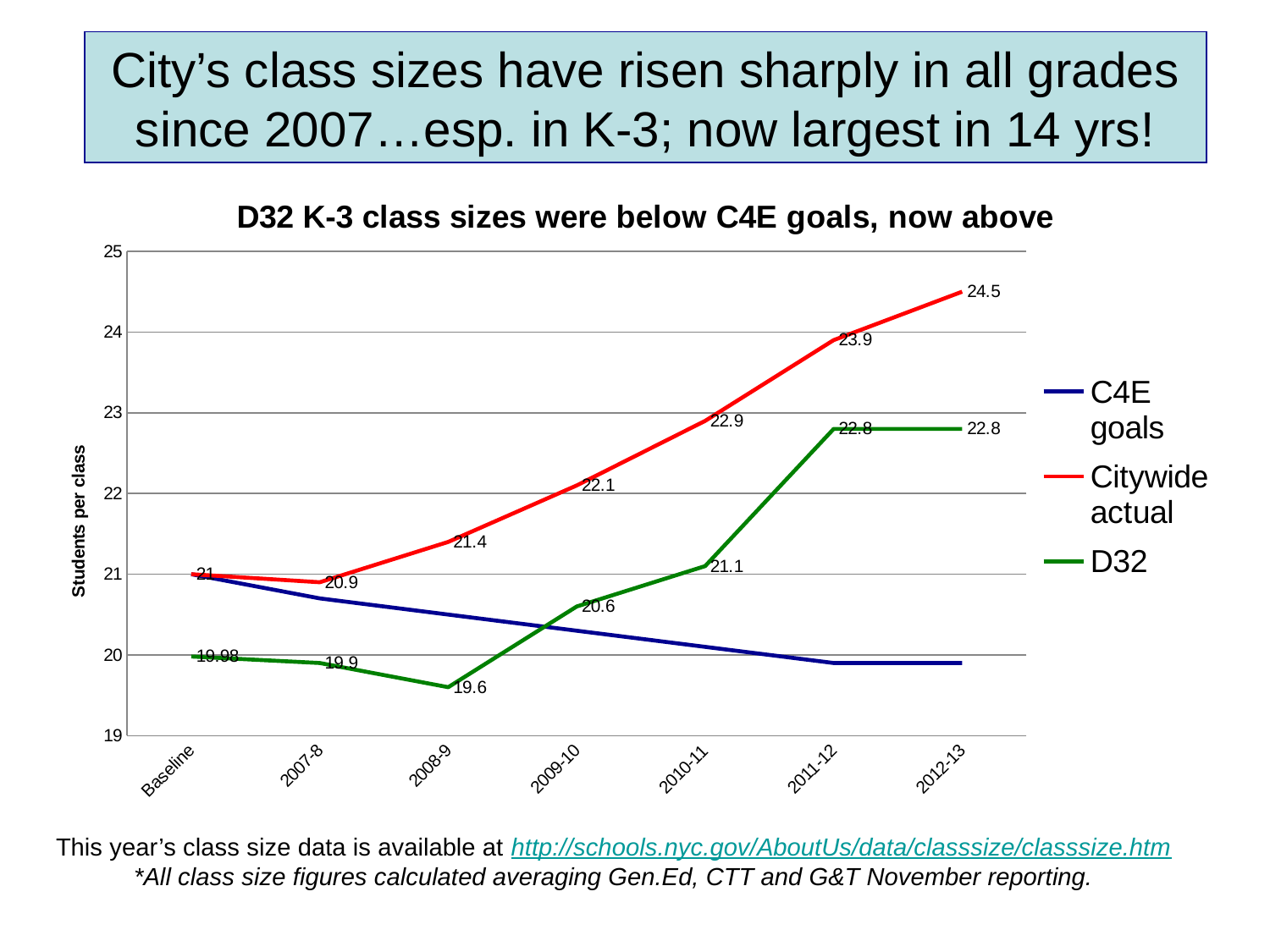
What is the Citywide actual value for 2012-13? 24.5 What is the title of the chart? D32 K-3 class sizes were below C4E goals, now above What is the D32 value for 2008-9? 19.6 How many categories are shown on the x axis? 7 What is the difference between the Citywide actual value in 2012-13 and at Baseline? 3.5 What type of chart is shown on the slide? line chart In which year is the Citywide actual value highest? 2012-13 What is the D32 value at Baseline? 19.98 In which year is the D32 value lowest? 2008-9 Which is larger in 2010-11, the Citywide actual value or the D32 value? Citywide actual How many series does the legend list? 3 Is the C4E goals value for 2009-10 greater or less than 21? less